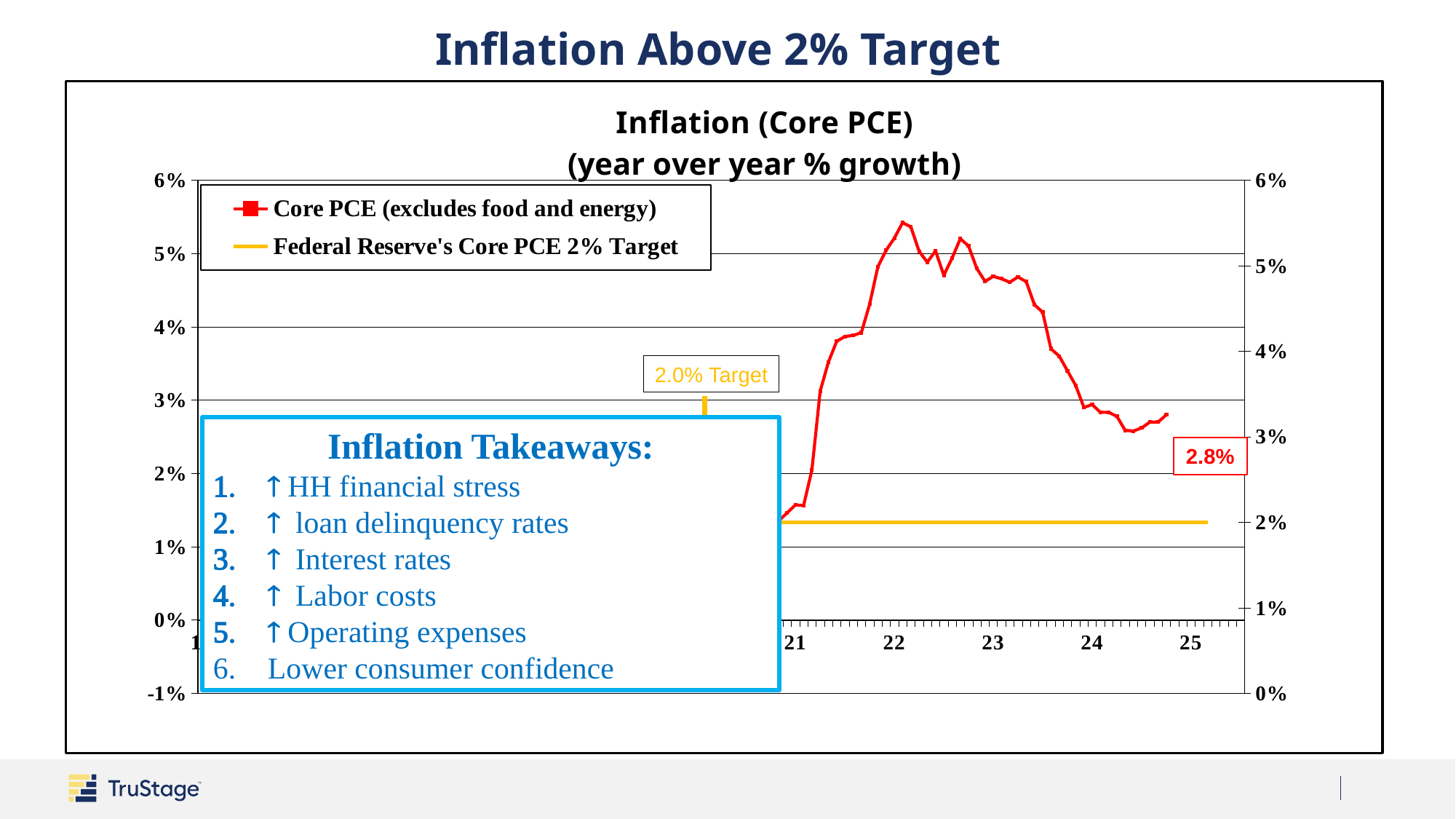
What is the most recent Core PCE value labeled on the chart? 2.8% By how many percentage points does the latest Core PCE value (2.8%) exceed the 2.0% target? 0.8 percentage points Does the Core PCE line rise or fall between 2021 and 2022? rise Is the Core PCE value at the start of 2023 greater or less than 4%? greater What does the yellow line in the chart represent, according to the legend? Federal Reserve's Core PCE 2% Target What text is shown in the callout label pointing to the yellow line? 2.0% Target Which is larger: the latest Core PCE value or the Federal Reserve's target? the latest Core PCE value (2.8%) What kind of chart is shown on the slide? line chart What is the title of the chart? Inflation (Core PCE) (year over year % growth) How many series does the chart legend list? 2 Is the peak Core PCE value in 2022 greater or less than 5%? greater Does the Core PCE line rise or fall between 2022 and 2024? fall